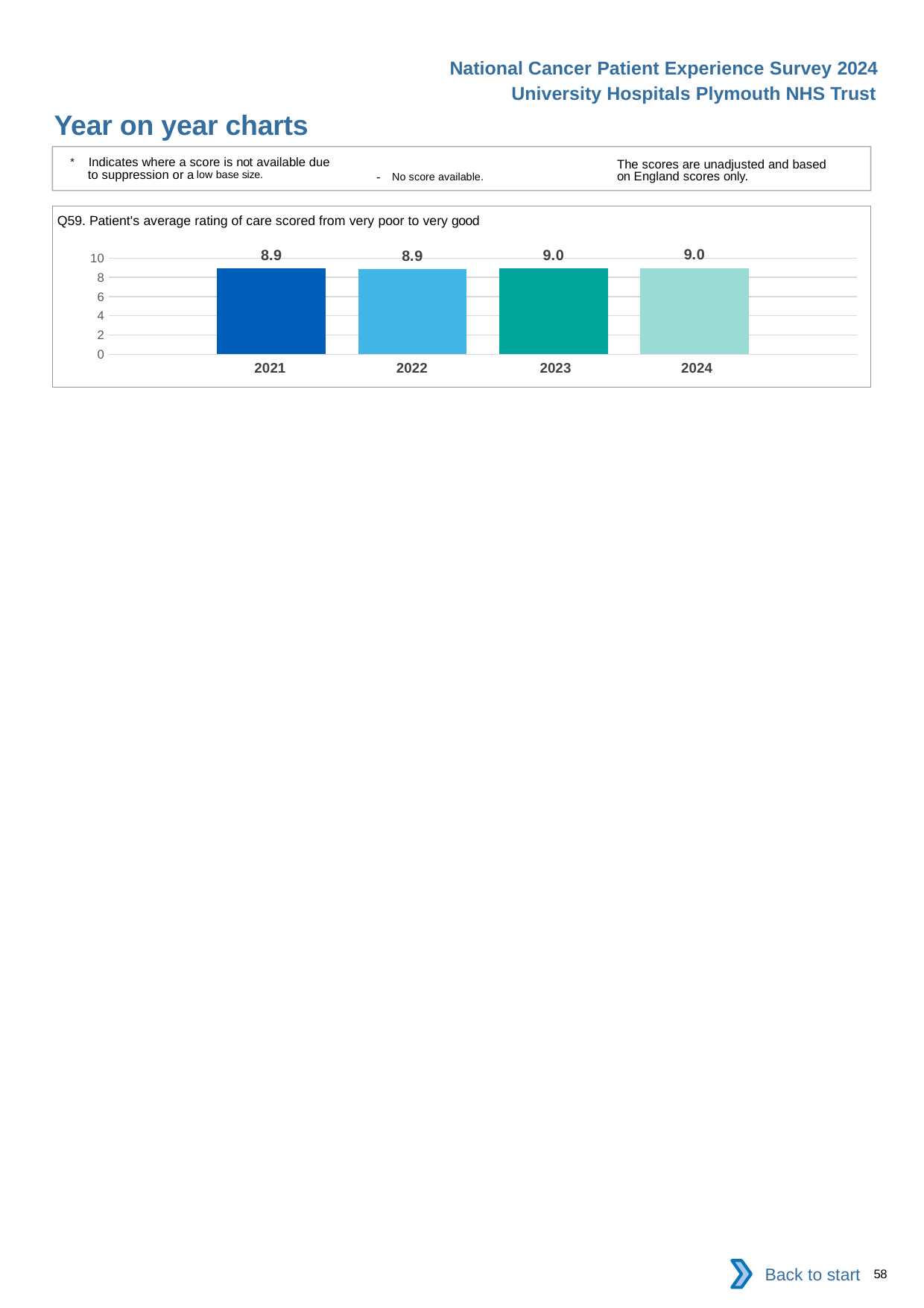
Which has the larger value, 2022 or 2024? 2024 What is the title of the chart? Q59. Patient's average rating of care scored from very poor to very good Is the value for 2021 greater or less than 8? greater What is the value for 2021? 8.9 What is the difference between the values for 2023 and 2021? 0.1 What is the value for 2023? 9.0 What is the value for 2024? 9.0 What is the lowest value shown on the chart? 8.9 What is the highest value shown on the chart? 9.0 What kind of chart is shown on the slide? bar chart How many years are shown on the chart? 4 What is the value for 2022? 8.9